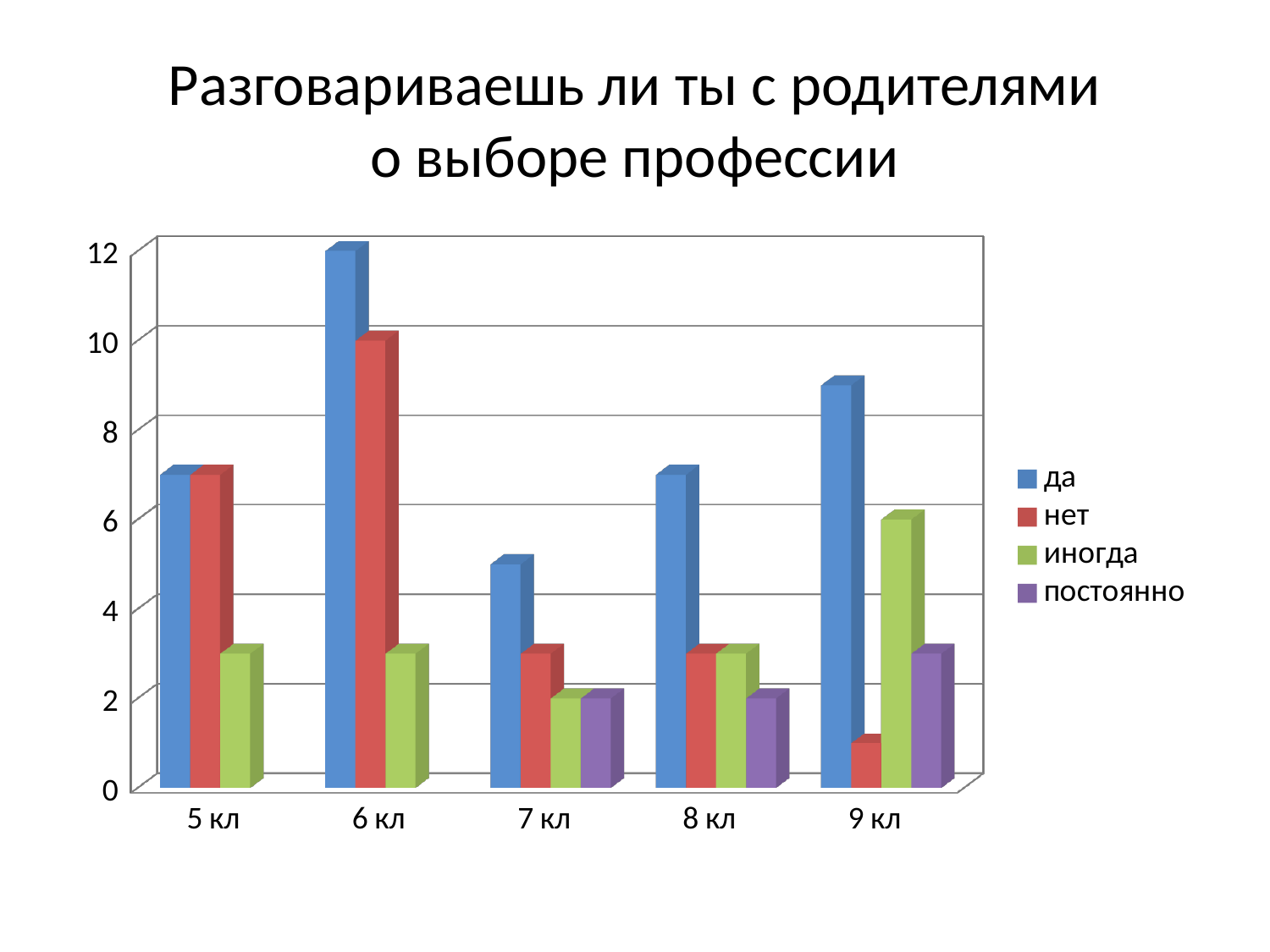
Is the value for "нет" in 9 кл greater or less than 2? less What kind of chart is shown on the slide? bar chart For 9 кл, which is larger: "иногда" or "постоянно"? иногда How many class categories are shown on the x axis? 5 What are the entries listed in the legend? да, нет, иногда, постоянно Which class has the lowest value for the series "нет"? 9 кл How many series does the legend list? 4 For 6 кл, which is larger: "да" or "нет"? да Is the value for "да" in 6 кл greater or less than 10? greater Which class has the highest value for the series "да"? 6 кл Which class has the highest value for the series "иногда"? 9 кл Is the value for "иногда" in 9 кл greater or less than 4? greater